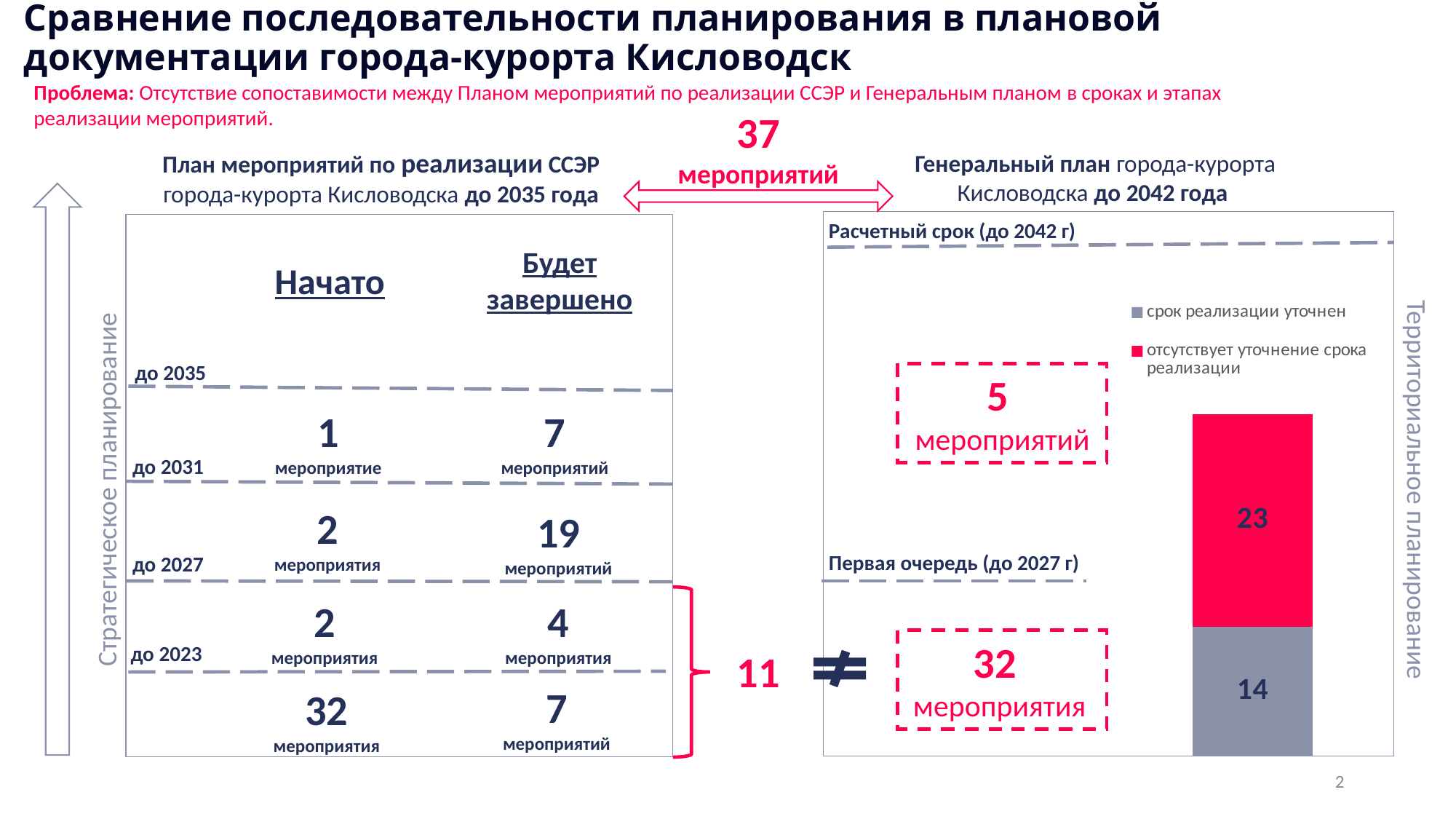
What kind of chart is shown on the right side of the slide, inside the 'Генеральный план' panel? stacked bar chart In the stacked bar chart on the right, what is the difference between the red segment (23) and the grey segment (14)? 9 In the stacked bar chart on the right, what colour is the segment for 'отсутствует уточнение срока реализации'? red In the stacked bar chart on the right, which series has the largest value? отсутствует уточнение срока реализации How many bars are plotted in the stacked bar chart on the right? 1 In the stacked bar chart on the right, which segment is larger: 'срок реализации уточнен' or 'отсутствует уточнение срока реализации'? отсутствует уточнение срока реализации How many series does the legend of the stacked bar chart on the right list? 2 In the stacked bar chart on the right, what is the value of the grey segment labelled 'срок реализации уточнен'? 14 In the stacked bar chart on the right, what is the total of the stacked bar? 37 In the stacked bar chart on the right, which series has the smallest value? срок реализации уточнен In the stacked bar chart on the right, what is the value of the red segment labelled 'отсутствует уточнение срока реализации'? 23 In the stacked bar chart on the right, what colour is the segment for 'срок реализации уточнен'? grey